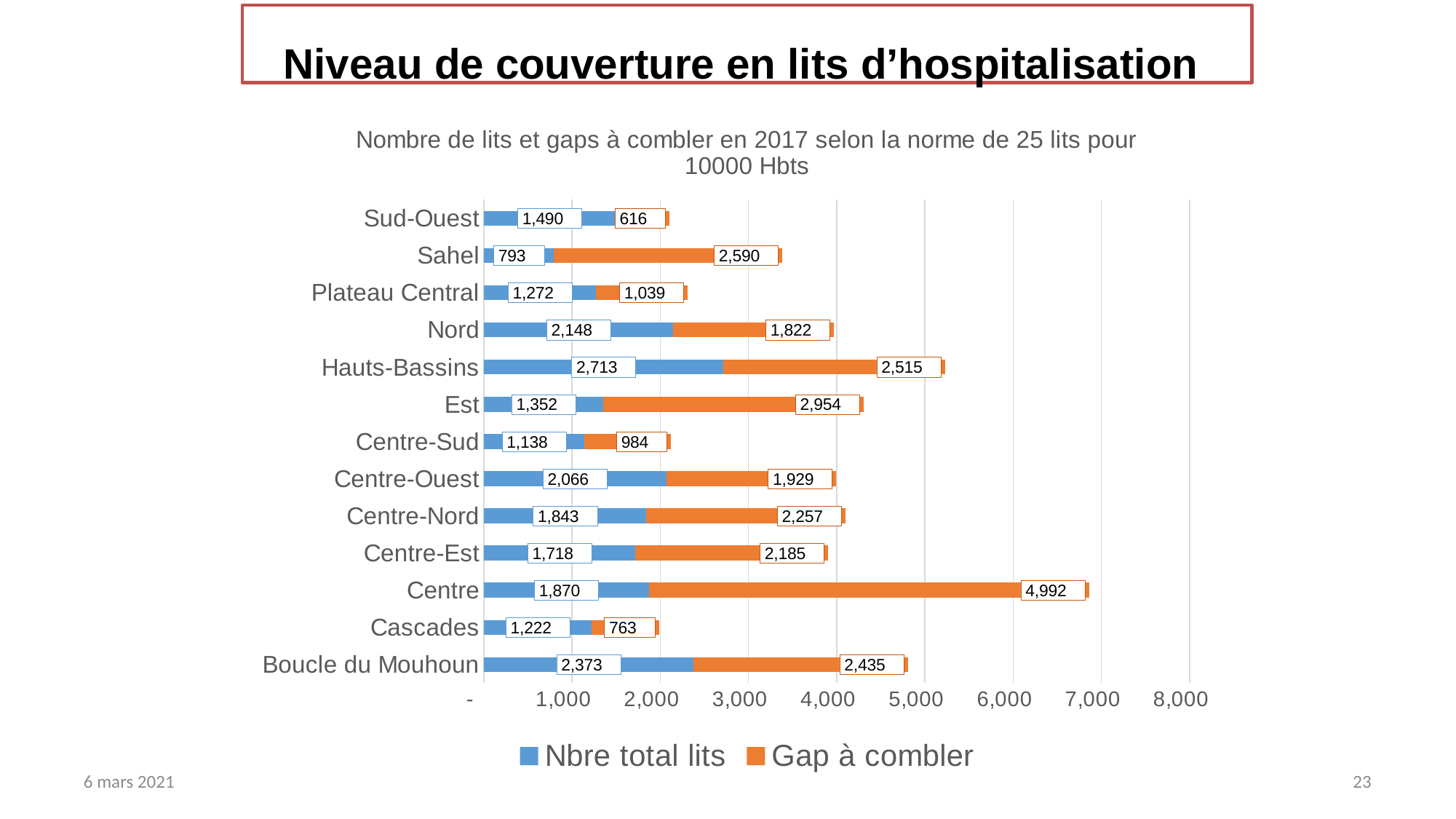
What is the difference between the Gap à combler for Hauts-Bassins and for Nord? 693 Which is larger, the Nbre total lits for Boucle du Mouhoun or for Centre-Ouest? Boucle du Mouhoun Which region has the lowest Nbre total lits? Sahel What is the value of Nbre total lits for Hauts-Bassins? 2,713 What is the total of the stacked bar for Centre (Nbre total lits plus Gap à combler)? 6,862 Which colour represents Gap à combler in the chart? Orange What is the Gap à combler value for Sahel? 2,590 Which region has the lowest Gap à combler? Sud-Ouest How many regions are shown on the chart? 13 How many series does the legend list? 2 Which region has the highest Gap à combler? Centre What kind of chart is shown on the slide? Stacked bar chart